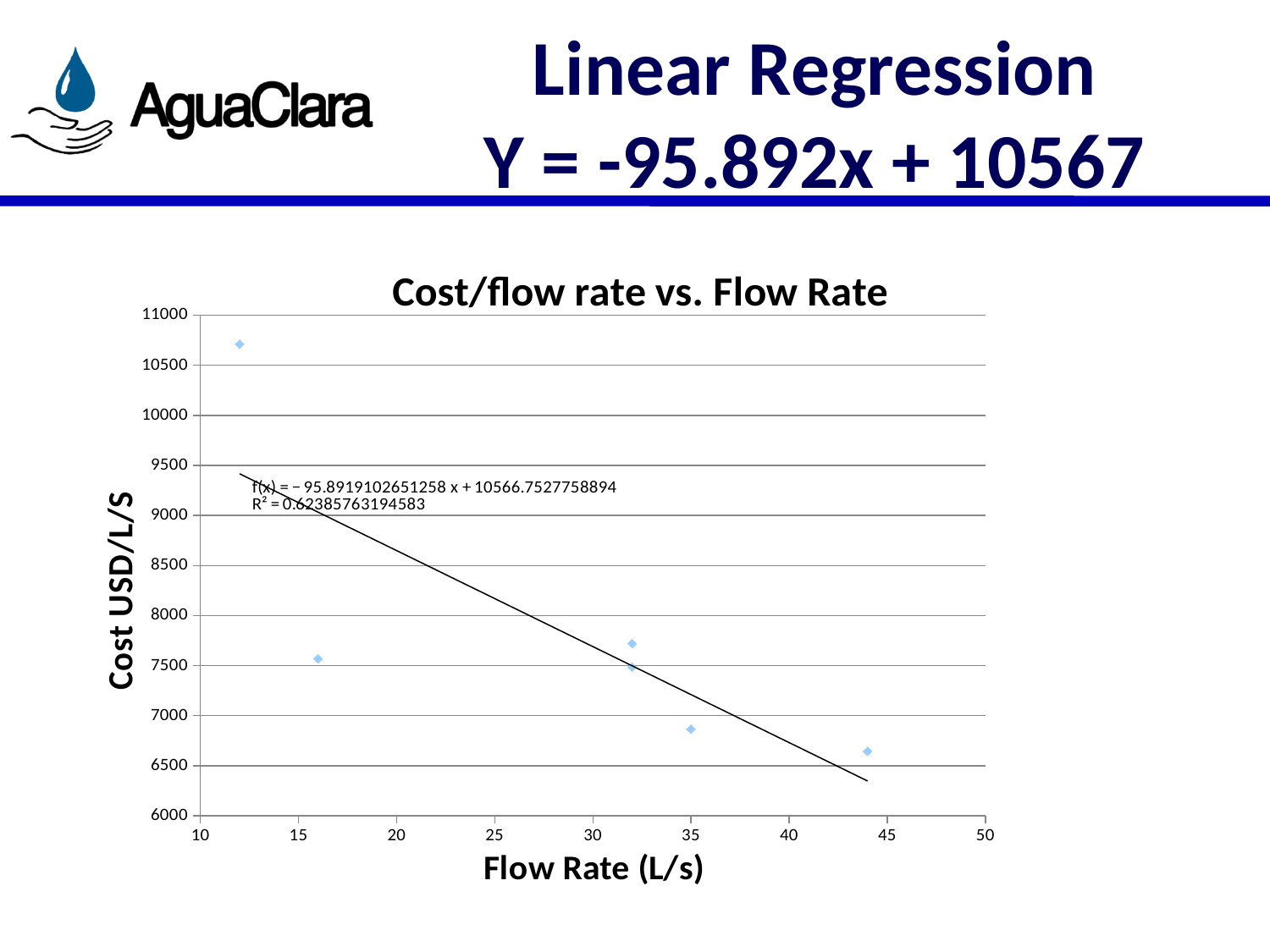
Which has the larger cost value: the point at flow rate 12 L/s or the point at flow rate 44 L/s? 12 L/s What is the title of the chart? Cost/flow rate vs. Flow Rate Is the cost value at a flow rate of 12 L/s greater or less than 10500? greater What kind of chart is shown on the slide? Scatter chart How many data points are plotted in the chart? 6 What R² value is printed on the chart for the trendline? 0.62385763194583 Is the cost value at a flow rate of 35 L/s greater or less than 7500? less Is the cost value at a flow rate of 16 L/s greater or less than 8000? less At which flow rate is the plotted cost lowest? 44 Do the plotted cost values generally rise or fall as flow rate increases? Fall At which flow rate is the plotted cost highest? 12